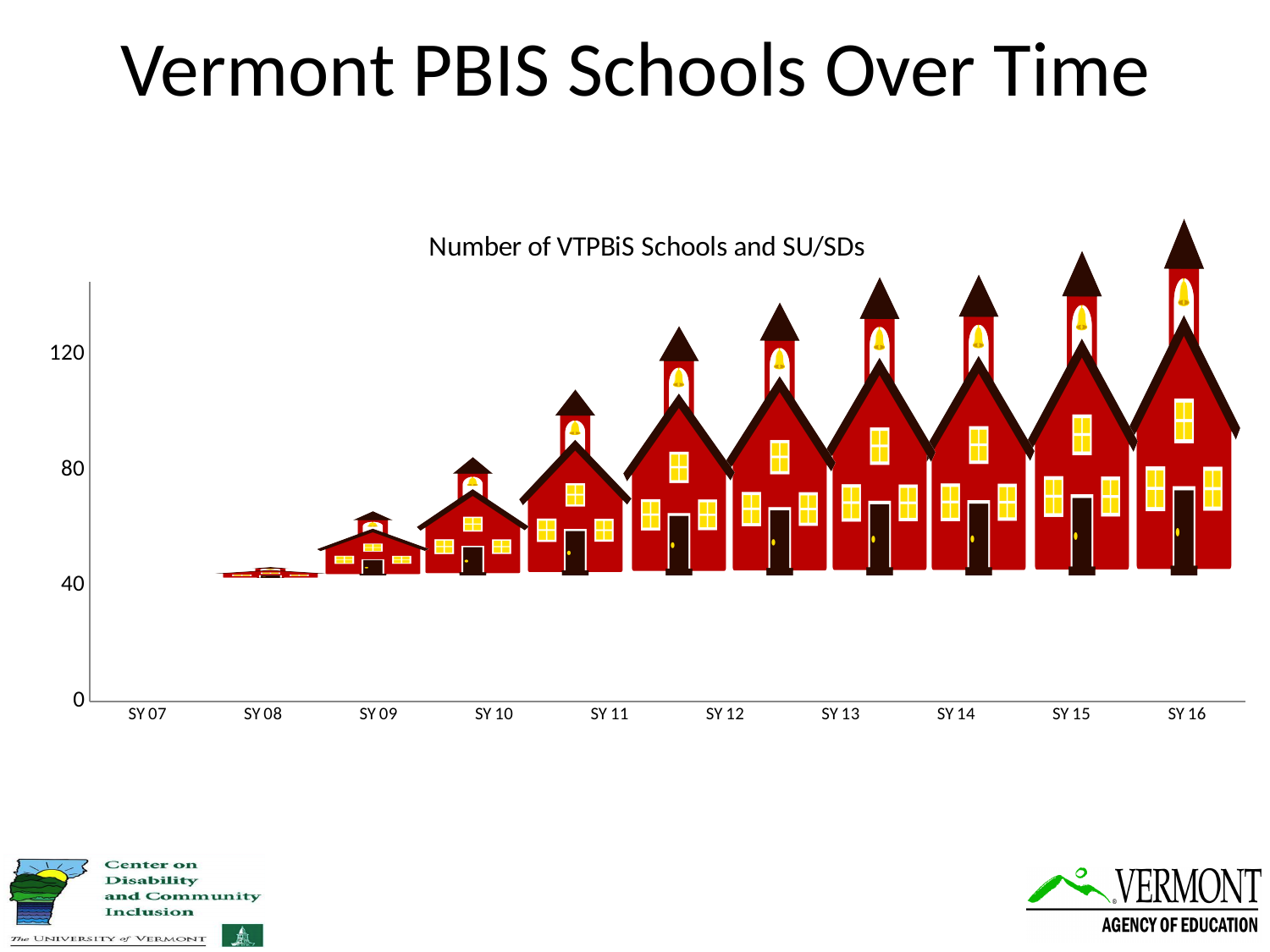
Is the value for SY 08 greater or less than 80? less Which is larger, the value for SY 12 or the value for SY 09? SY 12 Is the value for SY 09 greater or less than 80? less What is the highest value labelled on the y axis of the chart? 120 Do the values in the chart generally rise or fall from SY 08 to SY 16? rise Which school year has the tallest bar in the chart? SY 16 Is the value for SY 16 greater or less than 80? greater How many school years are shown on the x axis of the chart? 10 Which is larger, the value for SY 16 or the value for SY 11? SY 16 Which school year has the smallest visible bar in the chart? SY 08 What kind of chart is shown on the slide? bar chart What is the title of the chart? Number of VTPBiS Schools and SU/SDs